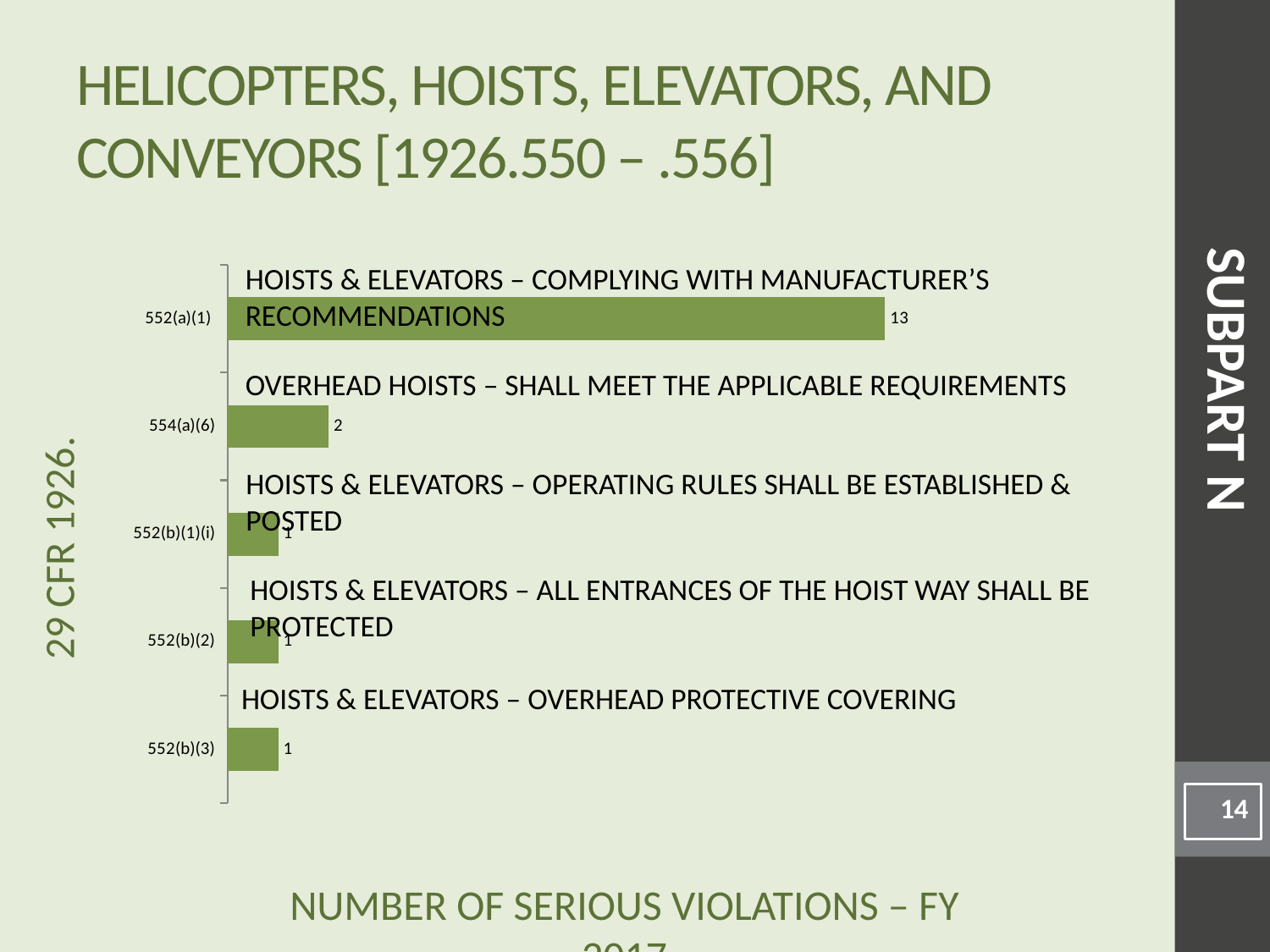
What is the difference between the values for 554(a)(6) and 552(b)(2)? 1 Which category has the highest number of serious violations? 552(a)(1) What kind of chart is shown on the slide? Bar chart How many categories have a value of 1? 3 How many categories are plotted in the chart? 5 What is the label on the vertical axis of the chart? 29 CFR 1926. What is the difference between the values for 552(a)(1) and 554(a)(6)? 11 What is the number of serious violations for 554(a)(6)? 2 What is the total of all the values plotted in the chart? 18 What is the number of serious violations for 552(b)(3)? 1 What is the number of serious violations for 552(a)(1)? 13 Which is larger, the value for 552(a)(1) or the value for 554(a)(6)? 552(a)(1)